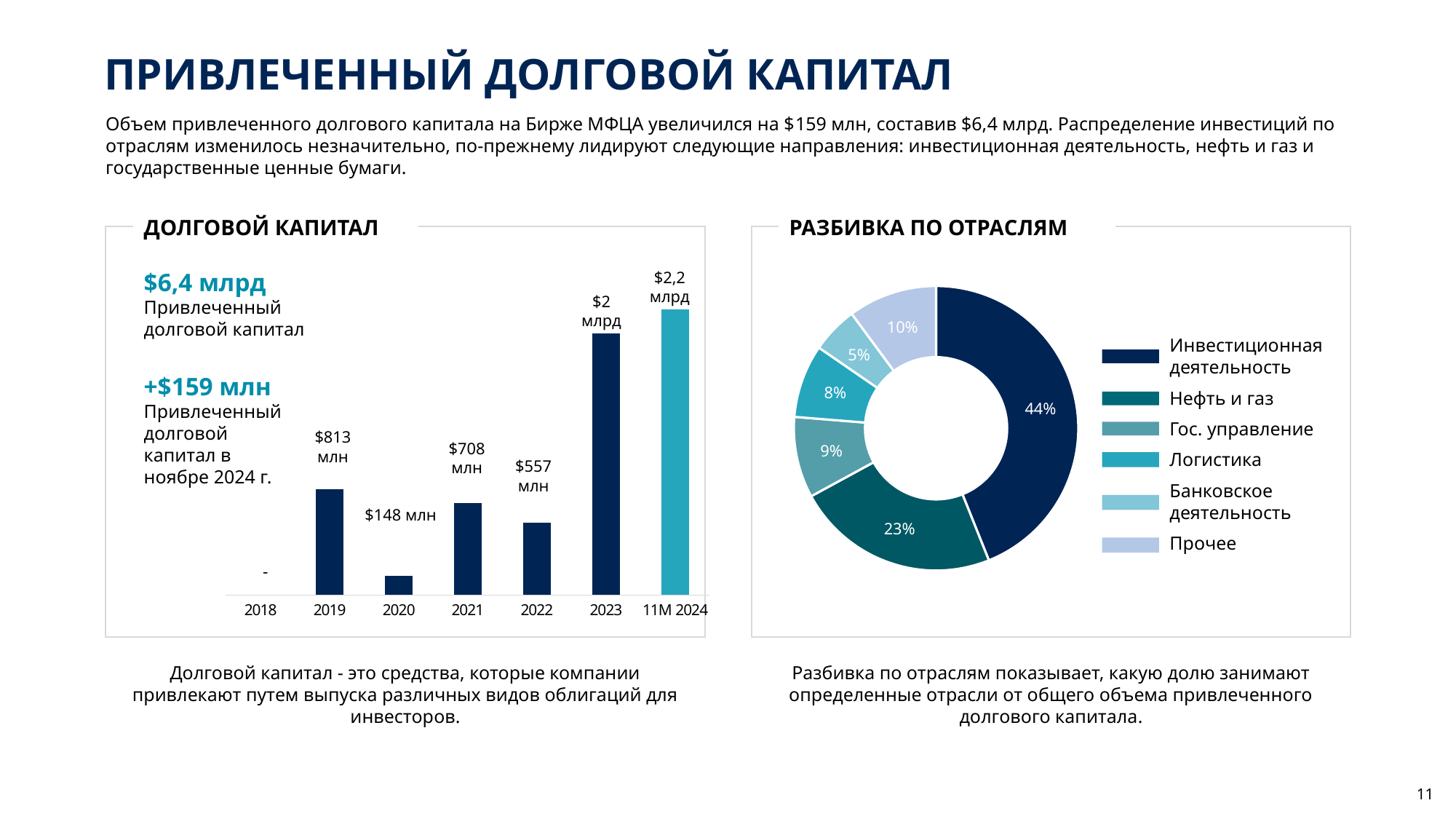
In the ДОЛГОВОЙ КАПИТАЛ chart, how many periods are shown on the x axis? 7 In the ДОЛГОВОЙ КАПИТАЛ chart, what is the value for 11M 2024? $2,2 млрд In the ДОЛГОВОЙ КАПИТАЛ chart, what is the difference between the 2019 and 2020 values? $665 млн In the РАЗБИВКА ПО ОТРАСЛЯМ chart, what share does Нефть и газ have? 23% How many entries does the legend of the РАЗБИВКА ПО ОТРАСЛЯМ chart list? 6 In the ДОЛГОВОЙ КАПИТАЛ chart, which is larger, the value for 2021 or for 2022? 2021 What kind of chart is the ДОЛГОВОЙ КАПИТАЛ chart? Bar chart In the ДОЛГОВОЙ КАПИТАЛ chart, which period has the highest value? 11M 2024 In the ДОЛГОВОЙ КАПИТАЛ chart, do the values rise or fall from 2022 to 11M 2024? Rise In the ДОЛГОВОЙ КАПИТАЛ chart, what is the value for 2019? $813 млн In the РАЗБИВКА ПО ОТРАСЛЯМ chart, which sector has the largest share? Инвестиционная деятельность In the ДОЛГОВОЙ КАПИТАЛ chart, among the years 2019 to 2023, which year has the lowest value? 2020